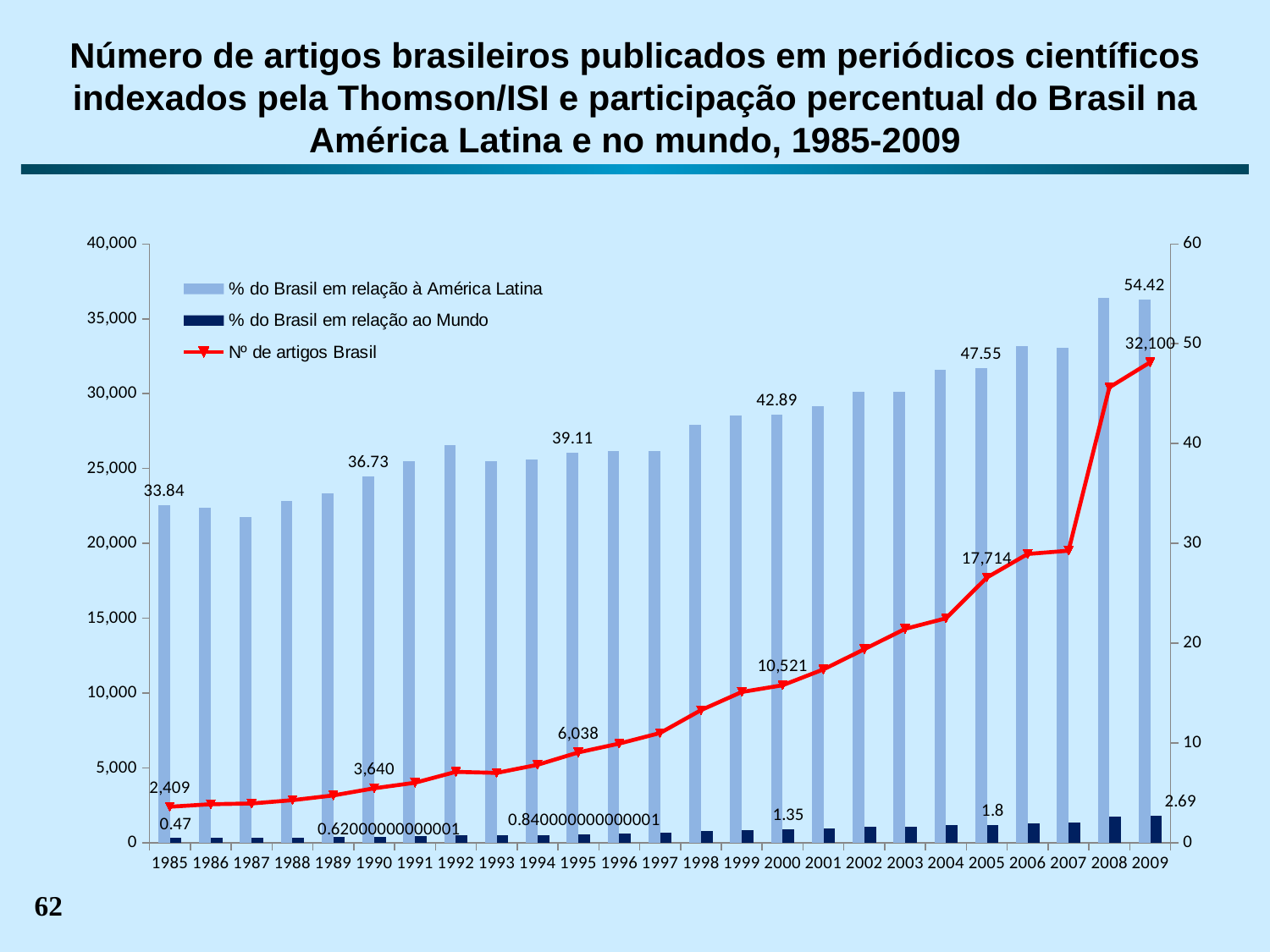
What is the value of % do Brasil em relação ao Mundo in 2009? 2.69 What is the difference between % do Brasil em relação à América Latina in 2009 and in 1985? 20.58 What is the value of Nº de artigos Brasil in 1985? 2,409 How many years are shown on the x axis? 25 By how much did Nº de artigos Brasil increase from 2005 to 2009? 14,386 Does Nº de artigos Brasil rise or fall from 1985 to 2009? rise What is the value of % do Brasil em relação à América Latina in 2005? 47.55 What is the value of Nº de artigos Brasil in 2009? 32,100 What is the value of % do Brasil em relação ao Mundo in 1985? 0.47 Which year has the higher Nº de artigos Brasil, 1995 or 2000? 2000 How many series does the legend list? 3